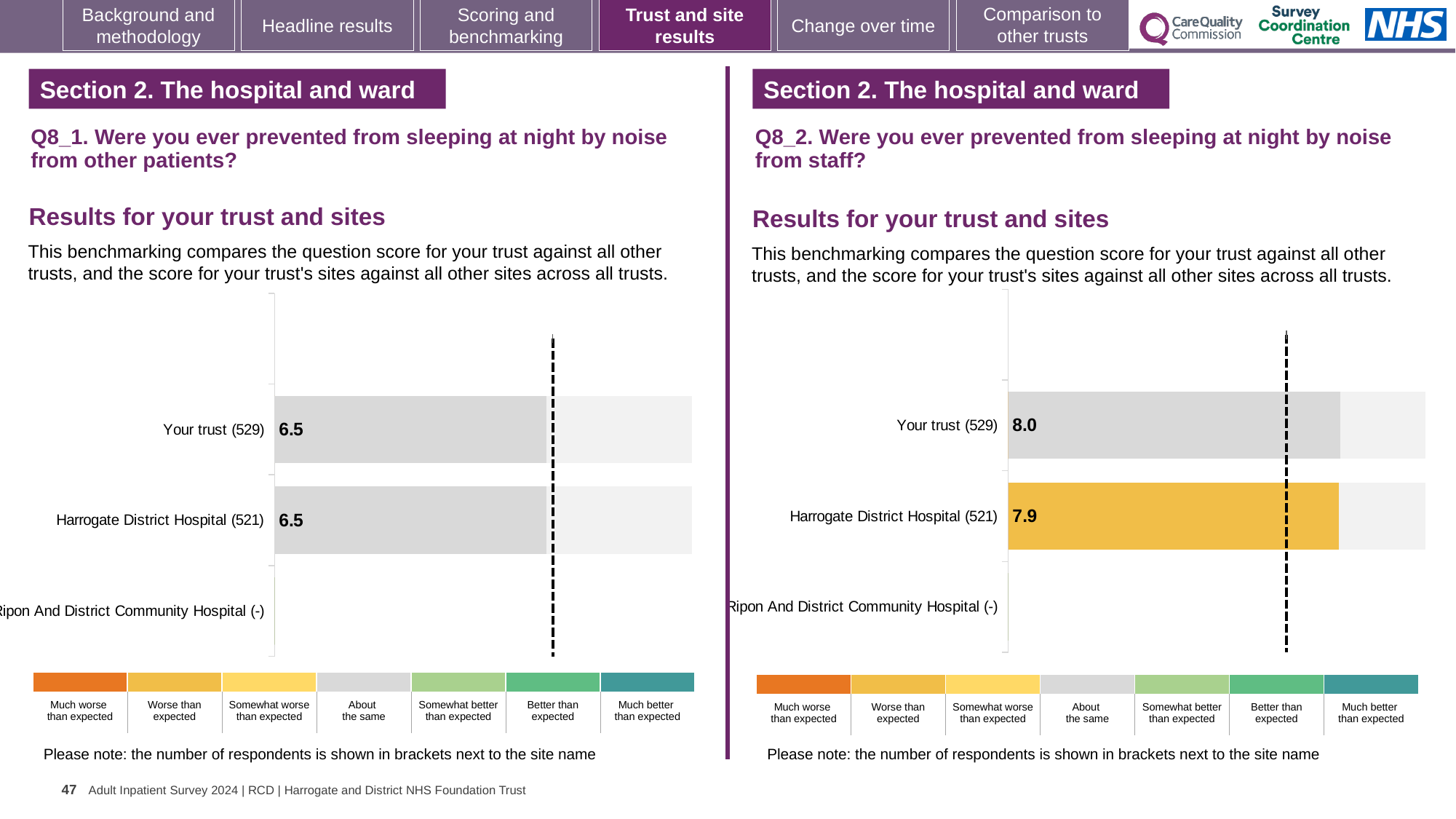
What kind of chart is used for the Q8_2 results (noise from staff)? Bar chart In the Q8_1 chart (noise from other patients), what is the score for Your trust (529)? 6.5 In the Q8_1 chart (noise from other patients), what is the difference between the score for Your trust and the score for Harrogate District Hospital? 0.0 In the Q8_1 chart, what is shown for Ripon And District Community Hospital? (-), no score shown In the Q8_1 chart (noise from other patients), which benchmark category does the colour of the Your trust bar correspond to? About the same In the Q8_2 chart (noise from staff), what is the score for Harrogate District Hospital (521)? 7.9 Comparing the Your trust scores, is the score higher in the Q8_1 chart or the Q8_2 chart? Q8_2 chart In the Q8_2 chart (noise from staff), which benchmark category does the colour of the Harrogate District Hospital bar correspond to? Worse than expected In the Q8_1 chart (noise from other patients), what is the score for Harrogate District Hospital (521)? 6.5 In the Q8_2 chart (noise from staff), what is the score for Your trust (529)? 8.0 In the Q8_2 chart (noise from staff), what is the difference between the score for Your trust and the score for Harrogate District Hospital? 0.1 How many site/trust categories are listed on the vertical axis of the Q8_1 chart? 3